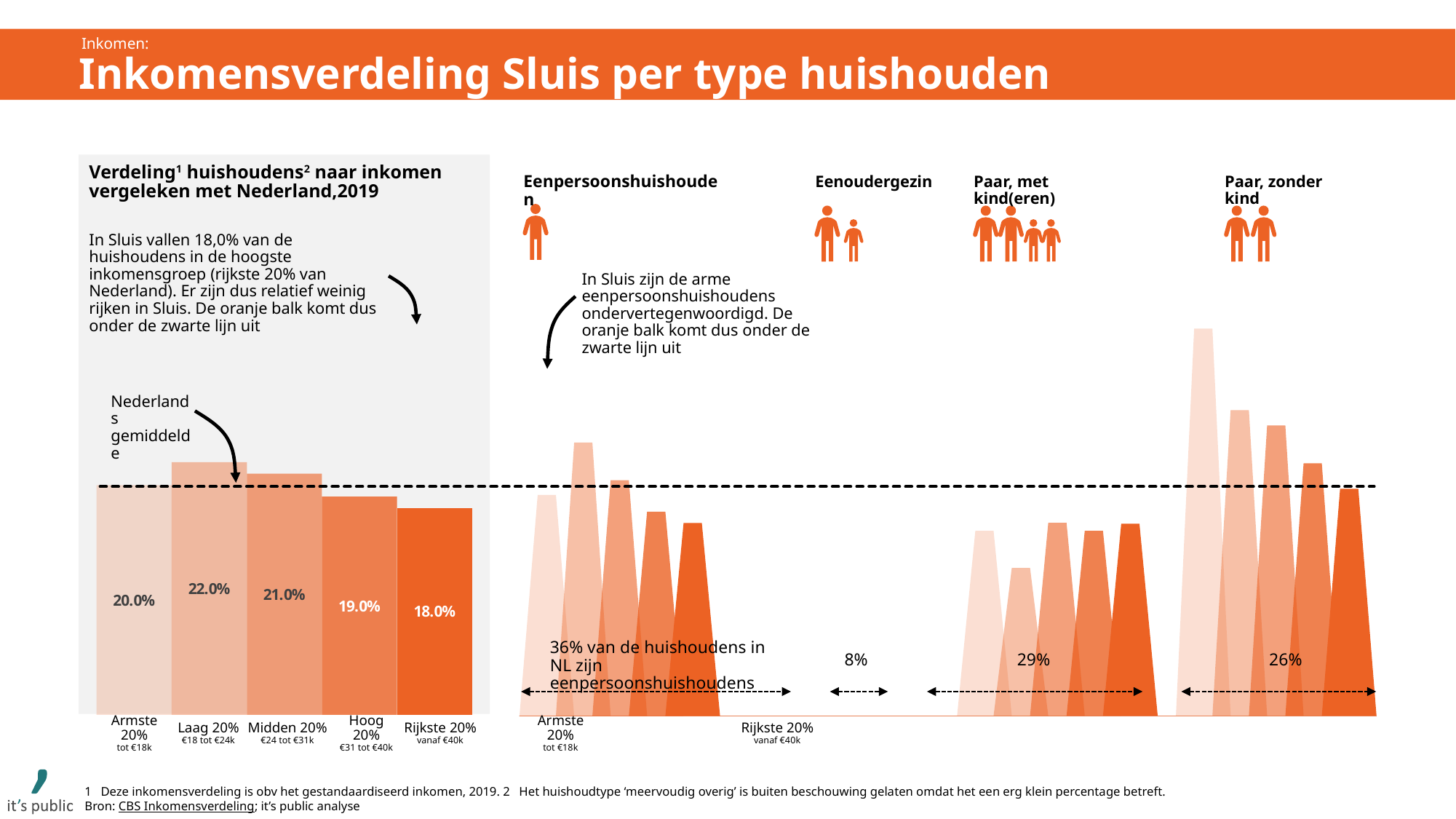
In the left chart, what is the value for Hoog 20%? 19.0% In the left chart, what is the value for Laag 20%? 22.0% In the left chart, what is the difference between the values for Laag 20% and Rijkste 20%? 4.0% In the left chart, which income group has the lowest value? Rijkste 20% In the left chart 'Verdeling huishoudens naar inkomen vergeleken met Nederland, 2019', what is the value for Rijkste 20%? 18.0% In the left chart, do the values rise or fall from Laag 20% to Rijkste 20%? fall How many income groups are shown in the left chart? 5 In the left chart, which is larger: the value for Midden 20% or for Hoog 20%? Midden 20% In the right-hand charts, what percentage of households in NL are eenpersoonshuishoudens? 36% In the left chart, what does the dashed horizontal line represent? Nederlands gemiddelde In the left chart, which income group has the highest value? Laag 20% What kind of chart is the left chart? bar chart